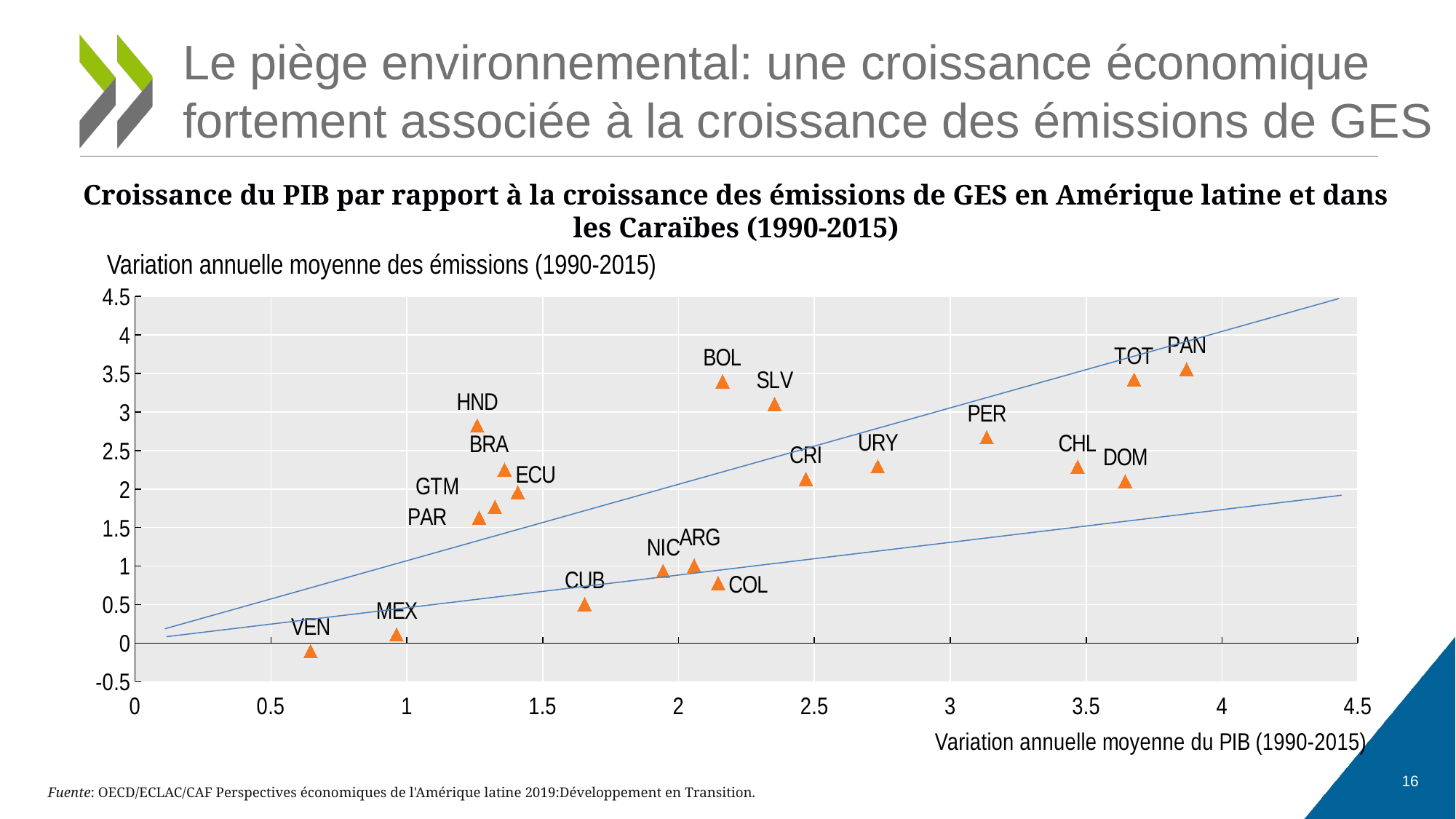
Which has the higher emissions variation, BOL or CRI? BOL Which country has the highest average annual GDP variation on the chart? PAN Which country has the lowest average annual emissions variation on the chart? VEN How many country points are plotted on the chart? 19 Is the emissions variation value for VEN greater or less than 0? less What kind of chart is shown on the slide? Scatter chart Is the GDP variation value for CHL greater or less than 3? greater Is the emissions variation value for BOL greater or less than 3? greater What is the label of the horizontal axis of the chart? Variation annuelle moyenne du PIB (1990-2015) Which has the higher emissions variation, HND or BRA? HND Which country has the lowest average annual GDP variation on the chart? VEN